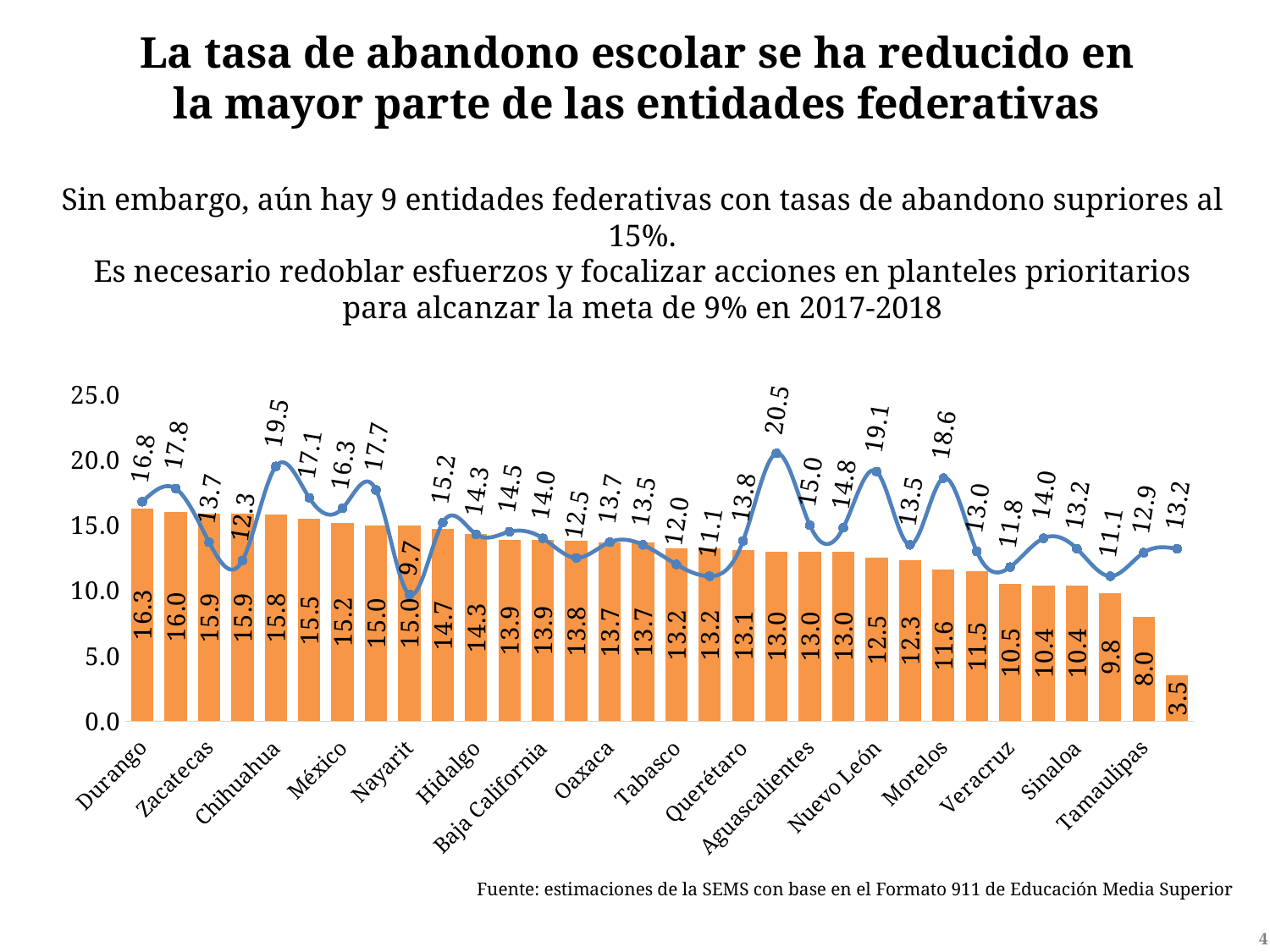
How many bars are plotted in the chart? 32 What is the highest tick shown on the vertical axis? 25.0 What is the highest bar value shown in the chart? 16.3 What is the lowest value on the line series? 9.7 What is the difference between the line value (16.8) and the bar value (16.3) for Durango? 0.5 What is the bar value for Durango? 16.3 What is the highest value on the line series? 20.5 For Chihuahua, which is larger: the bar value or the line value? The line value (19.5) Do the bar values rise or fall from left to right across the chart? Fall What is the line value for Nayarit? 9.7 What is the lowest bar value shown in the chart? 3.5 What kind of chart is shown on the slide? Bar chart with a line overlay